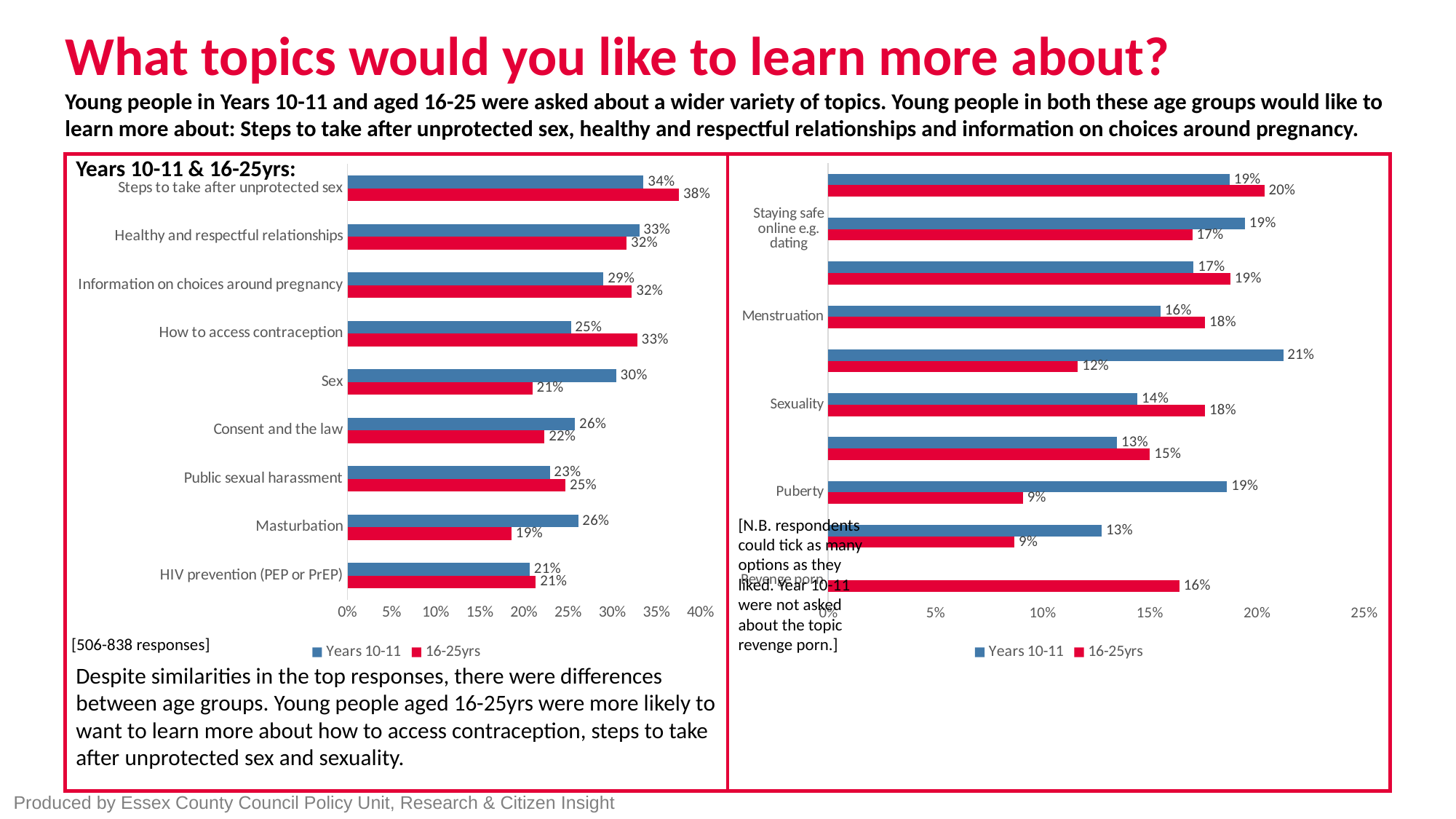
In the right chart, what is the 16-25yrs value for Revenge porn? 16% What type of chart is the left chart? Bar chart In the left chart, which topic has the highest 16-25yrs value? Steps to take after unprotected sex In the left chart, which topic has the lowest Years 10-11 value? HIV prevention (PEP or PrEP) What are the two legend entries in the left chart? Years 10-11 and 16-25yrs How many series does the legend of the left chart list? 2 How many topics are listed in the left chart? 9 In the left chart, what is the difference between the 16-25yrs and Years 10-11 values for How to access contraception? 8 percentage points In the left chart (Years 10-11 & 16-25yrs), what percentage of Years 10-11 respondents wanted to learn more about Sex? 30% In the left chart, for Sex, which age group has the larger value: Years 10-11 or 16-25yrs? Years 10-11 In the left chart, is the Years 10-11 value for Steps to take after unprotected sex greater or less than 30%? greater In the left chart, what is the 16-25yrs value for How to access contraception? 33%